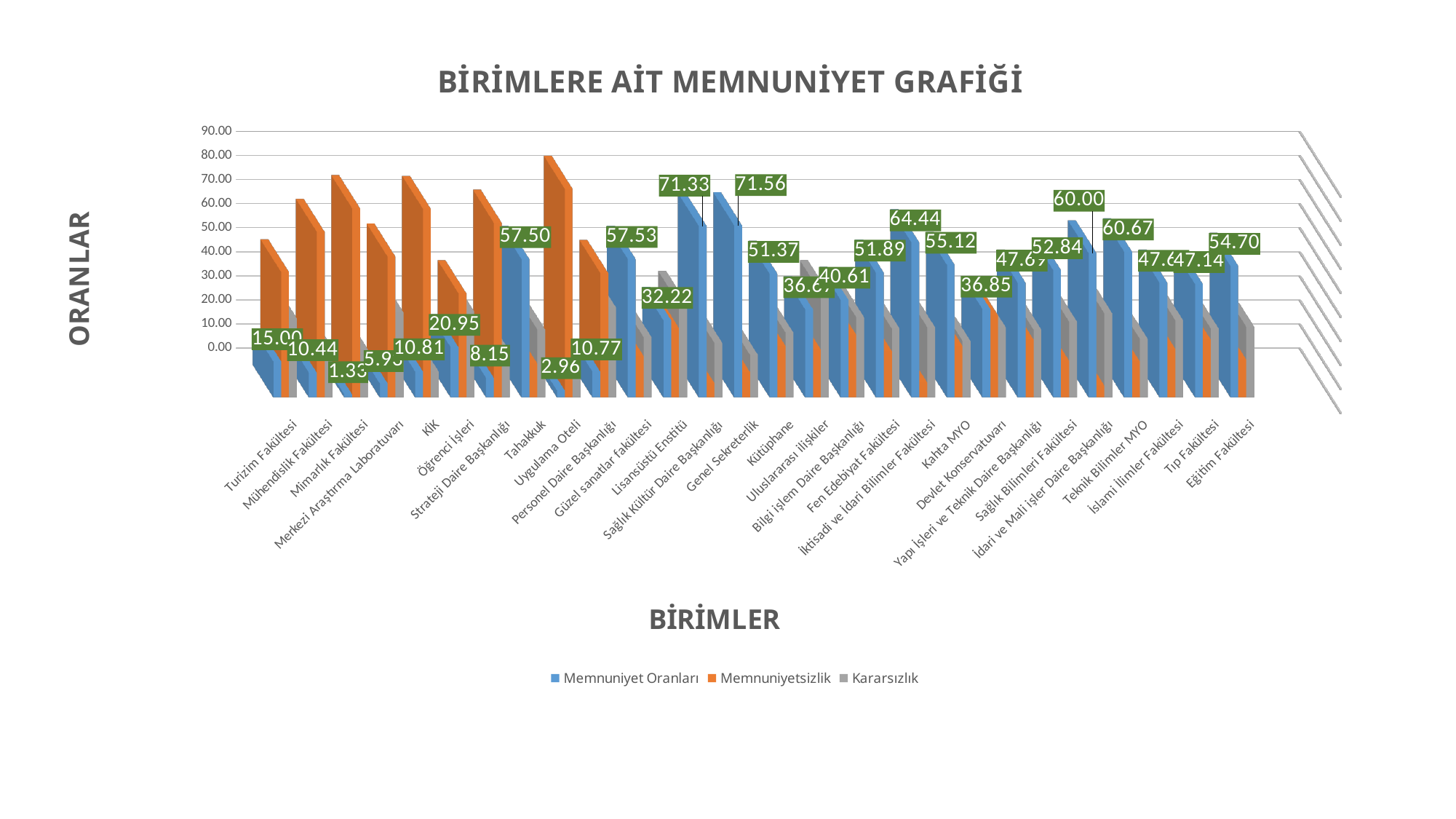
How many units (categories) are shown on the x axis? 28 What is the Memnuniyet Oranları value for Genel Sekreterlik? 71.56 Which has a higher Memnuniyet Oranları value, Kütüphane or Kahta MYO? Kahta MYO How many series does the legend list? 3 Which unit has the highest Memnuniyet Oranları value? Genel Sekreterlik What type of chart is shown on the slide? bar chart What is the Memnuniyet Oranları value for Tahakkuk? 57.50 What is the Memnuniyet Oranları value for Mimarlık Fakültesi? 1.33 Which unit has the lowest Memnuniyet Oranları value? Mimarlık Fakültesi What is the Memnuniyet Oranları value for İktisadi ve İdari Bilimler Fakültesi? 64.44 What is the title of the chart? BİRİMLERE AİT MEMNUNİYET GRAFİĞİ What is the difference between the Memnuniyet Oranları values for Teknik Bilimler MYO and İdari ve Mali İşler Daire Başkanlığı? 0.67